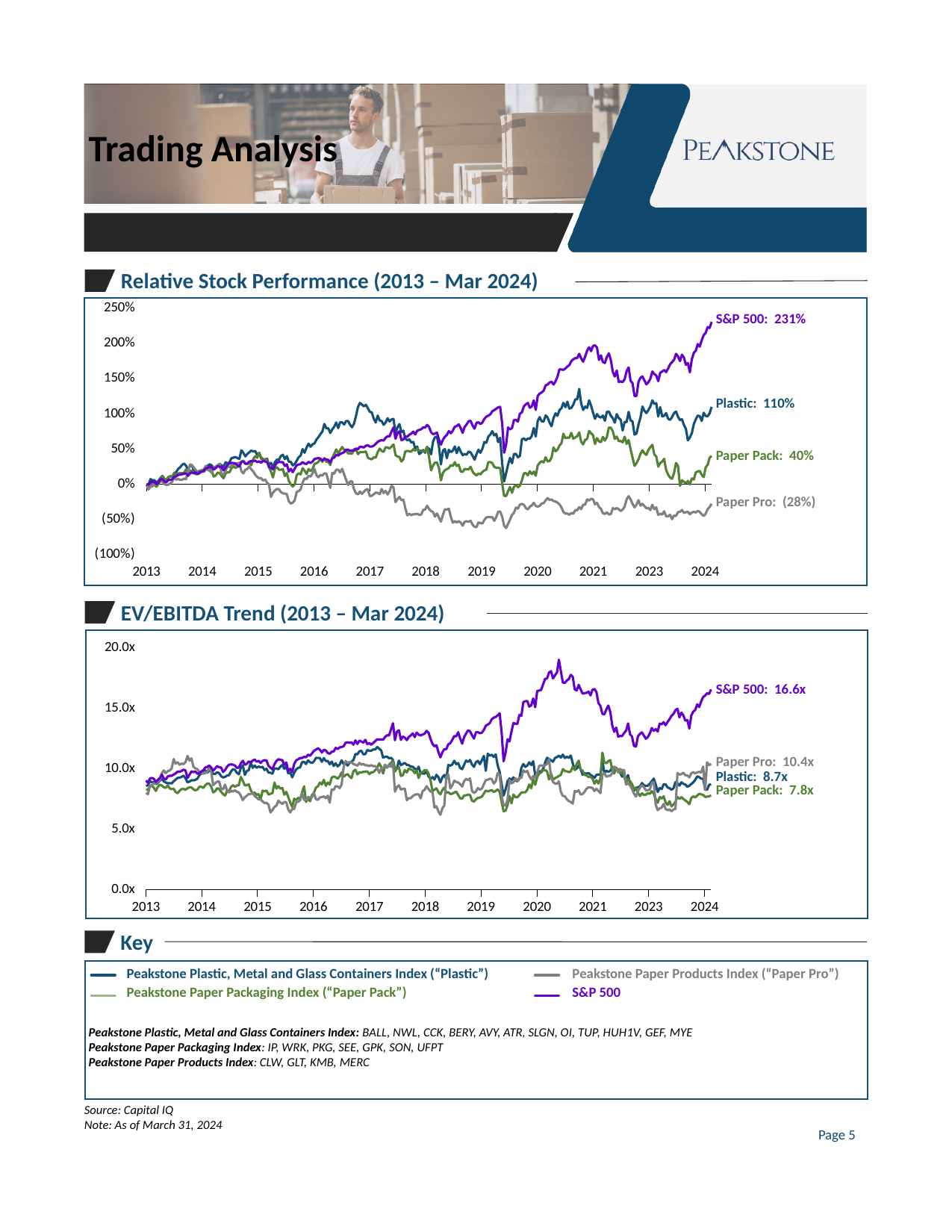
In the Relative Stock Performance chart, what is the final value shown for Paper Pro? (28%) What kind of chart is the EV/EBITDA Trend chart? Line chart In the EV/EBITDA Trend chart, what is the final value shown for Paper Pack? 7.8x In the Relative Stock Performance chart, which series has the lowest labelled end value? Paper Pro In the Relative Stock Performance chart, which series has the highest labelled end value? S&P 500 In the EV/EBITDA Trend chart, what is the final value shown for Paper Pro? 10.4x In the Relative Stock Performance chart, what is the final value shown for the S&P 500? 231% In the EV/EBITDA Trend chart, which series has the lowest labelled end value? Paper Pack In the Relative Stock Performance chart, is the final S&P 500 value greater or less than 200%? greater In the Relative Stock Performance chart, which is larger at the end of the period: Plastic or Paper Pack? Plastic In the EV/EBITDA Trend chart, what is the difference between the final S&P 500 value and the final Paper Pack value? 8.8x How many series does the Key list for the charts? 4